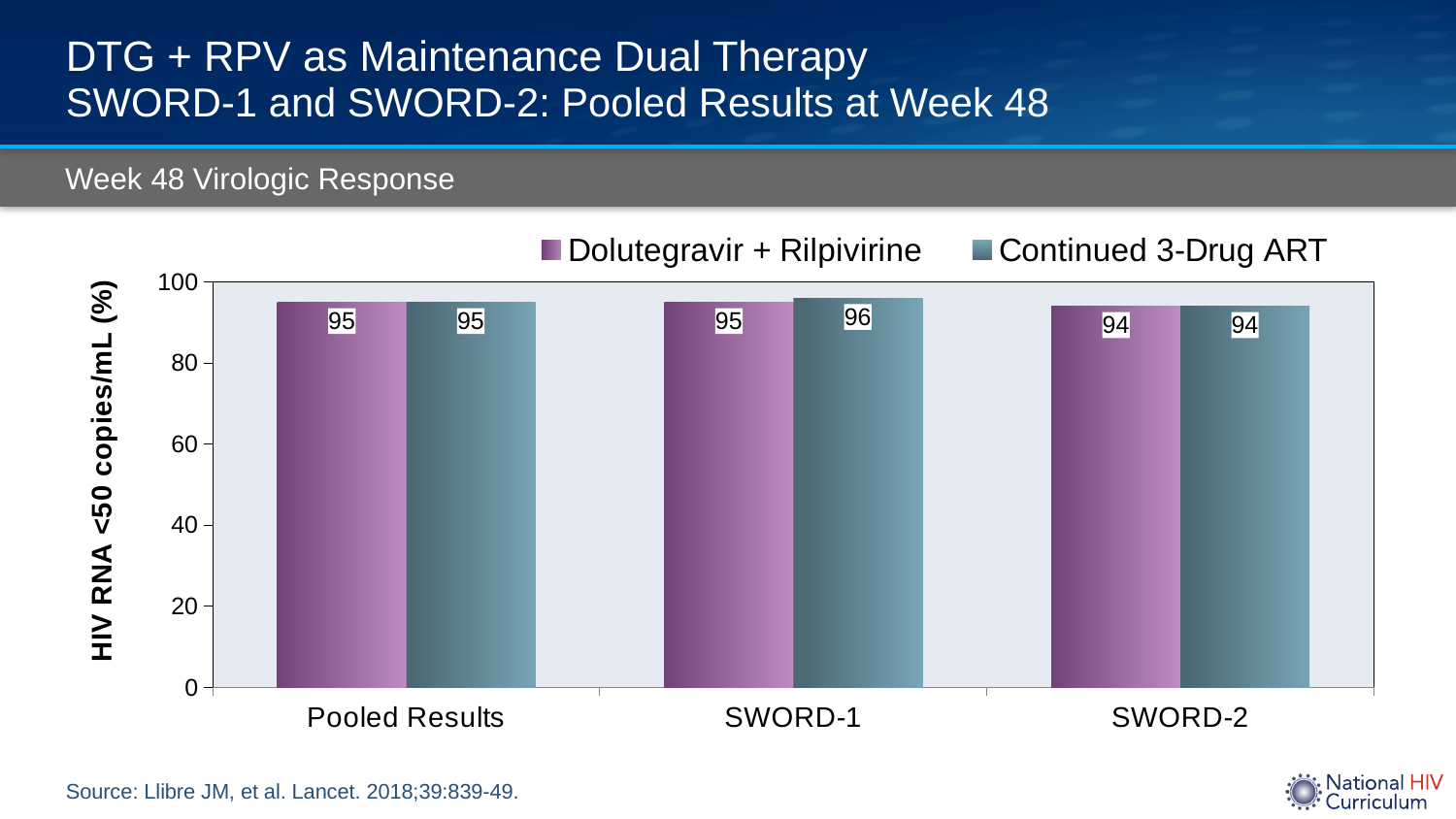
What is the value for Continued 3-Drug ART in SWORD-2? 94 What is the y-axis label of the chart? HIV RNA <50 copies/mL (%) In which category does Continued 3-Drug ART have its highest value? SWORD-1 What is the value for Dolutegravir + Rilpivirine in the Pooled Results category? 95 How many categories are shown on the x axis? 3 What is the difference between Continued 3-Drug ART and Dolutegravir + Rilpivirine in SWORD-1? 1 What type of chart is shown on the slide? bar chart What is the value for Continued 3-Drug ART in SWORD-1? 96 In SWORD-1, which is larger: Dolutegravir + Rilpivirine or Continued 3-Drug ART? Continued 3-Drug ART Is the value for Dolutegravir + Rilpivirine in SWORD-2 greater or less than 80? greater How many series does the legend list? 2 What is the value for Dolutegravir + Rilpivirine in SWORD-2? 94